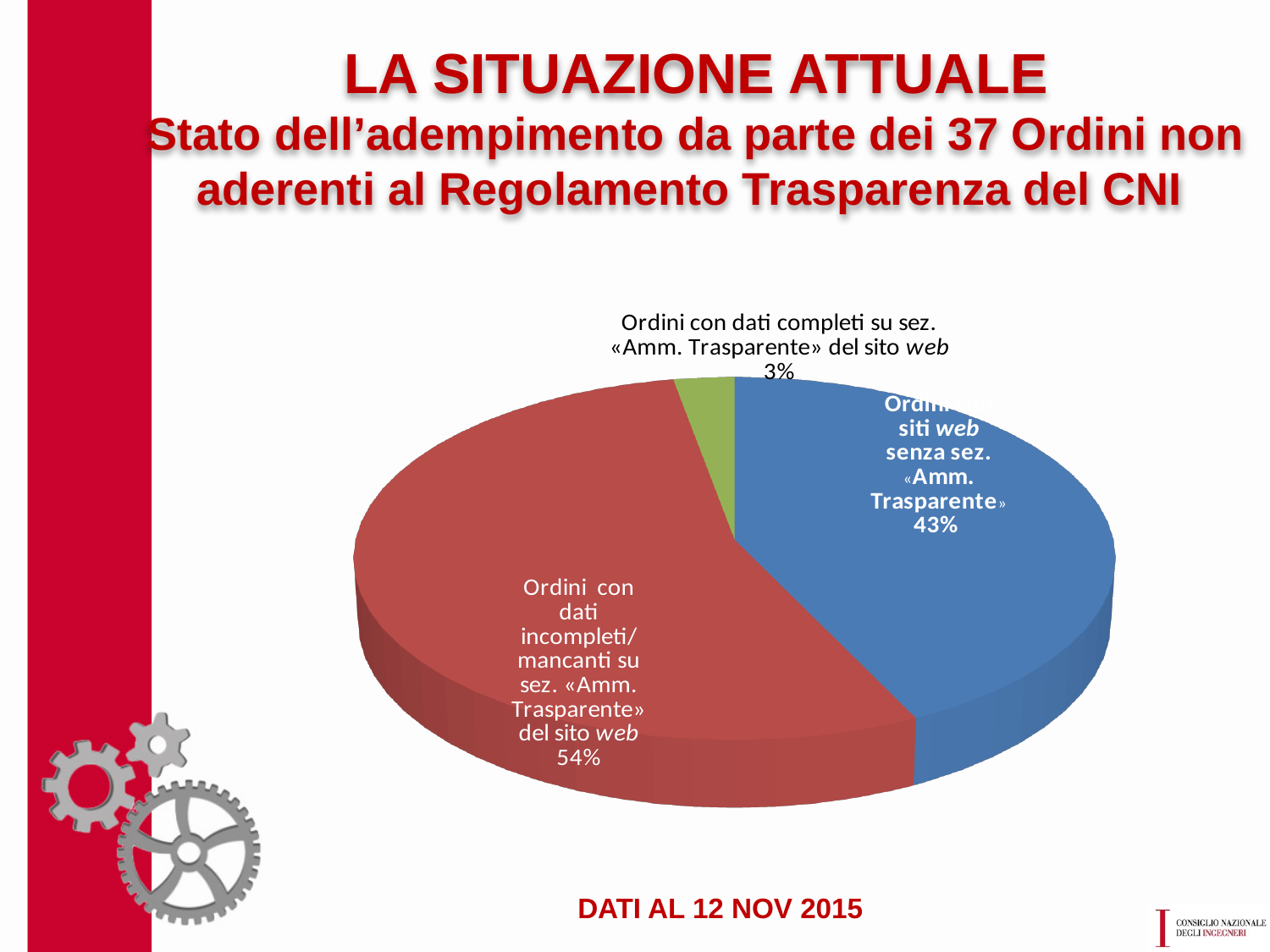
Which slice of the pie chart is the smallest? Ordini con dati completi su sez. «Amm. Trasparente» del sito web What is the difference in percentage points between the "dati incompleti/mancanti" slice and the "siti web senza sez. «Amm. Trasparente»" slice? 11 percentage points What is the combined share of the 43% and 3% slices? 46% Which is larger: the share of Ordini with sites lacking an «Amm. Trasparente» section, or the share with complete data? Ordini con siti web senza sez. «Amm. Trasparente» How many slices does the pie chart have? 3 What kind of chart is shown on the slide? Pie chart What colour is the slice representing 54% of the pie? Red What share of the pie is labelled "Ordini con siti web senza sez. «Amm. Trasparente»"? 43% What share of the pie is labelled "Ordini con dati completi su sez. «Amm. Trasparente» del sito web"? 3% Which slice of the pie chart is the largest? Ordini con dati incompleti/mancanti su sez. «Amm. Trasparente» del sito web What share of the pie is labelled "Ordini con dati incompleti/mancanti su sez. «Amm. Trasparente» del sito web"? 54% What date are the data on the slide reported as of? 12 NOV 2015